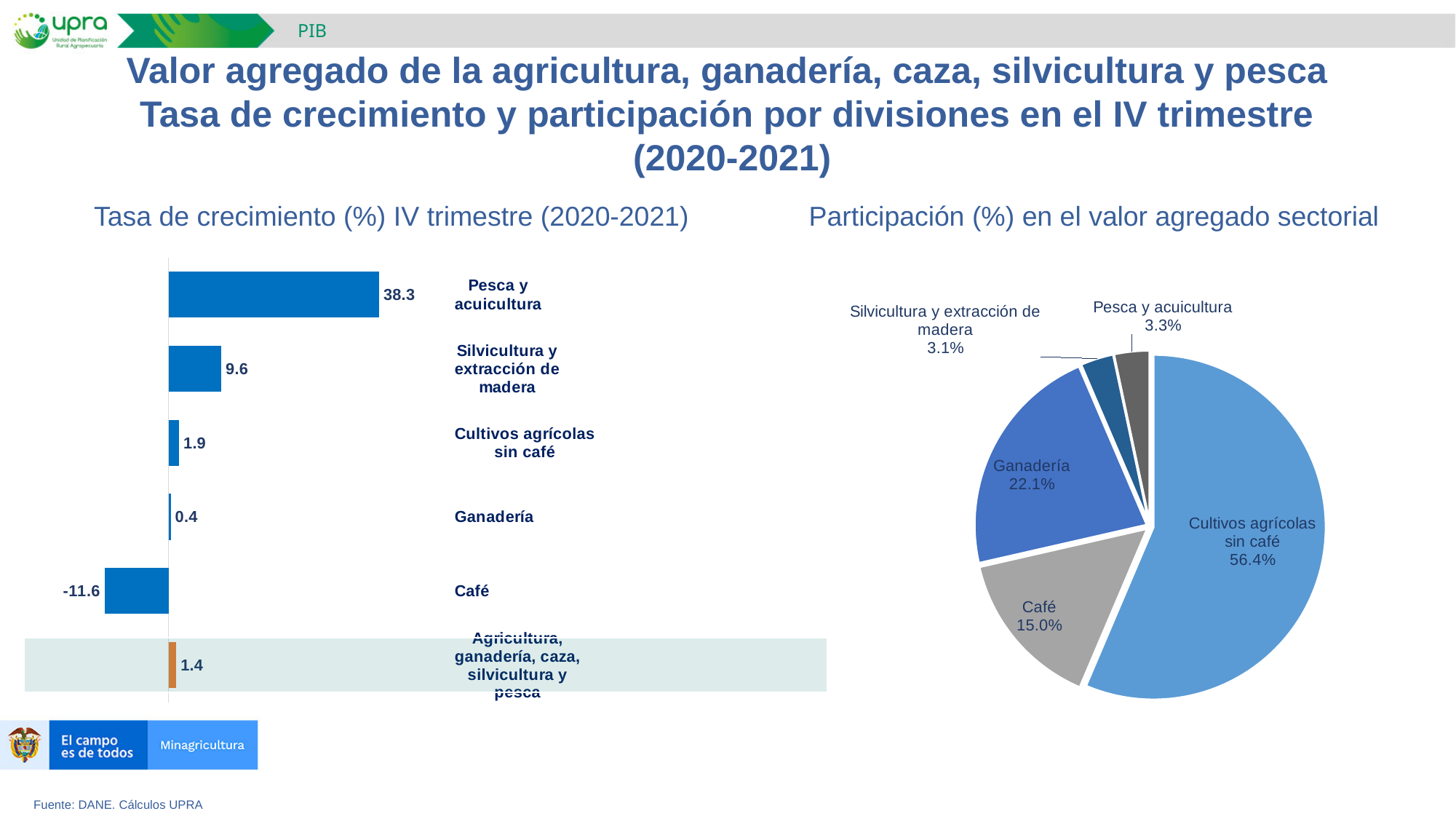
What kind of chart is the 'Tasa de crecimiento (%) IV trimestre (2020-2021)' chart? Bar chart In the 'Tasa de crecimiento (%) IV trimestre (2020-2021)' chart, which category has the highest value? Pesca y acuicultura In the 'Participación (%) en el valor agregado sectorial' chart, which slice is the largest? Cultivos agrícolas sin café In the 'Tasa de crecimiento (%) IV trimestre (2020-2021)' chart, how many categories are shown? 6 What kind of chart is the 'Participación (%) en el valor agregado sectorial' chart? Pie chart In the 'Tasa de crecimiento (%) IV trimestre (2020-2021)' chart, what is the value for Silvicultura y extracción de madera? 9.6 In the 'Tasa de crecimiento (%) IV trimestre (2020-2021)' chart, what is the difference between the values for Pesca y acuicultura and Silvicultura y extracción de madera? 28.7 In the 'Tasa de crecimiento (%) IV trimestre (2020-2021)' chart, which is larger: the value for Cultivos agrícolas sin café or the value for Ganadería? Cultivos agrícolas sin café In the 'Participación (%) en el valor agregado sectorial' chart, what share does Ganadería have? 22.1% In the 'Tasa de crecimiento (%) IV trimestre (2020-2021)' chart, what is the value for Café? -11.6 In the 'Tasa de crecimiento (%) IV trimestre (2020-2021)' chart, what is the value for Pesca y acuicultura? 38.3 In the 'Tasa de crecimiento (%) IV trimestre (2020-2021)' chart, which category has the lowest value? Café